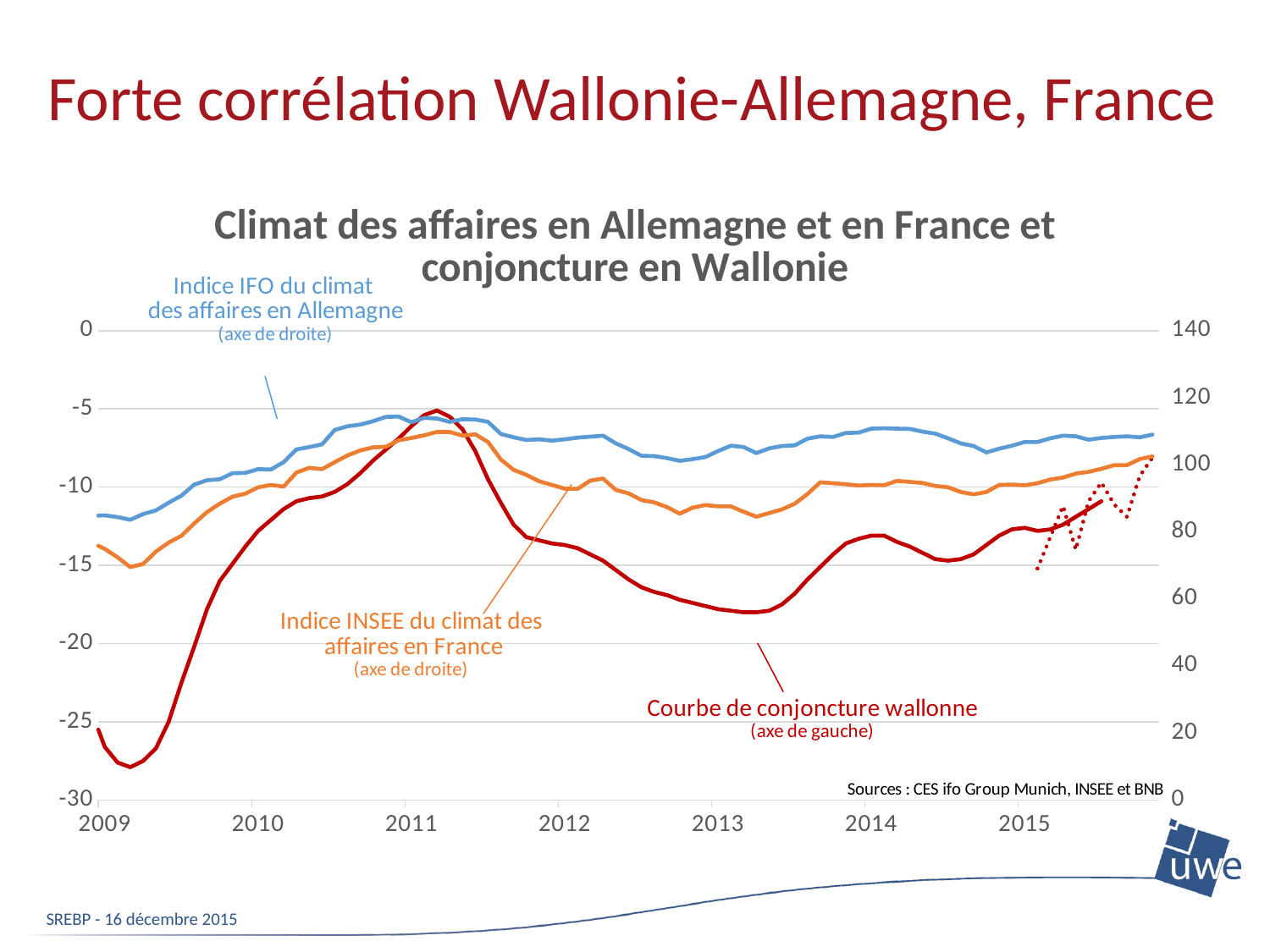
What kind of chart is shown on the slide? line chart Does the Courbe de conjoncture wallonne rise or fall between 2009 and 2011? rise How many year labels are shown on the x axis? 7 Is the value of the Courbe de conjoncture wallonne at the start of 2013 greater or less than -15? less Is the value of the Courbe de conjoncture wallonne at its 2011 peak greater or less than -10? greater Is the value of the Indice INSEE du climat des affaires en France at the start of 2013 greater or less than 100? less At the start of 2013, which is higher: the Indice IFO (Allemagne) or the Indice INSEE (France)? Indice IFO (Allemagne) Which axis does the Courbe de conjoncture wallonne use, left or right? left (axe de gauche) How many series are plotted on the chart? 4 What is the title of the chart? Climat des affaires en Allemagne et en France et conjoncture en Wallonie